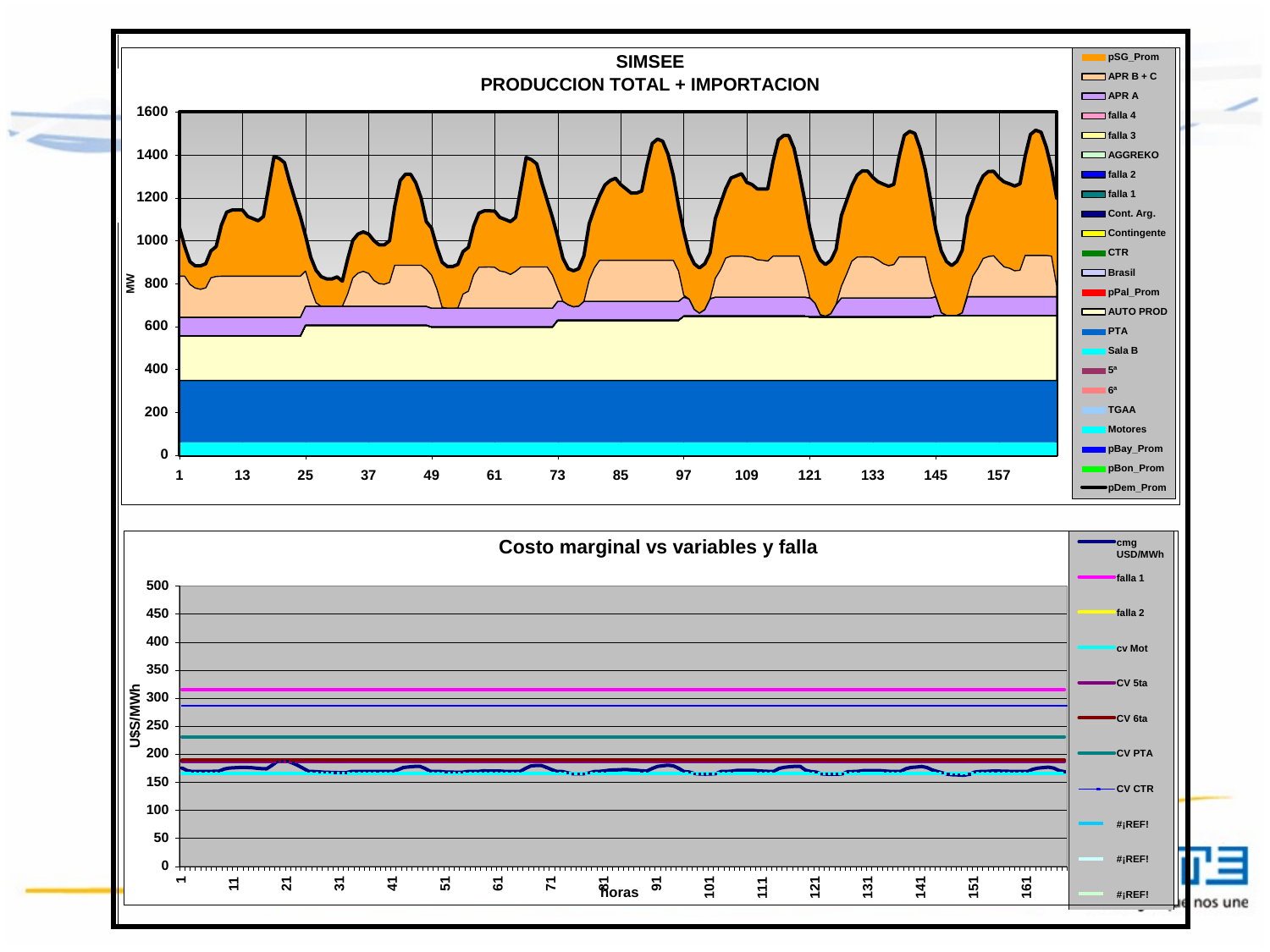
In the bottom chart 'Costo marginal vs variables y falla', is the value of the falla 2 line greater or less than 250? greater In the top chart 'SIMSEE PRODUCCION TOTAL + IMPORTACION', how many series does the legend list? 23 What is the y-axis label of the top chart 'SIMSEE PRODUCCION TOTAL + IMPORTACION'? MW In the bottom chart 'Costo marginal vs variables y falla', which series has the highest line? falla 1 What kind of chart is the bottom chart titled 'Costo marginal vs variables y falla'? line chart In the bottom chart 'Costo marginal vs variables y falla', how many entries does the legend list? 11 In the bottom chart 'Costo marginal vs variables y falla', what is the maximum value shown on the y-axis? 500 In the bottom chart 'Costo marginal vs variables y falla', is the value of the falla 1 line greater or less than 300? greater What kind of chart is the top chart titled 'SIMSEE PRODUCCION TOTAL + IMPORTACION'? stacked area chart What is the x-axis label of the bottom chart 'Costo marginal vs variables y falla'? horas In the top chart 'SIMSEE PRODUCCION TOTAL + IMPORTACION', is the highest peak of the pDem_Prom line greater or less than 1600? less